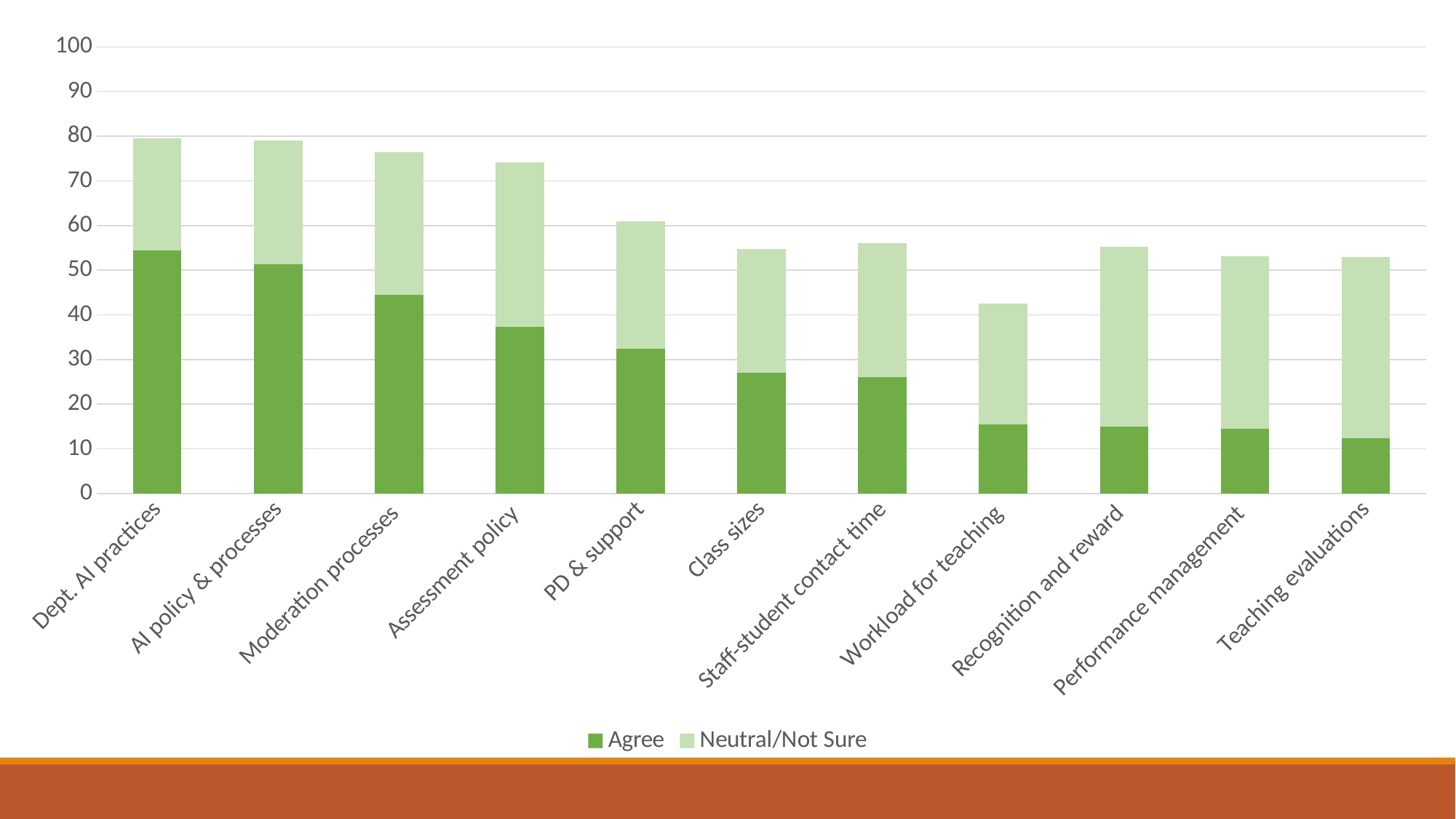
Is the total stacked bar for Workload for teaching greater or less than 50? less Is the Agree value for PD & support greater or less than 30? greater Do the Agree values generally rise or fall moving from left to right along the x axis? fall What kind of chart is shown on the slide? Stacked bar chart Which category has the lowest total stacked bar? Workload for teaching Which category has the highest Agree value? Dept. AI practices Which has the larger Agree value, Moderation processes or Assessment policy? Moderation processes How many series does the legend list? 2 Is the Agree value for Dept. AI practices greater or less than 50? greater What are the two series named in the legend? Agree and Neutral/Not Sure How many categories are shown along the x axis? 11